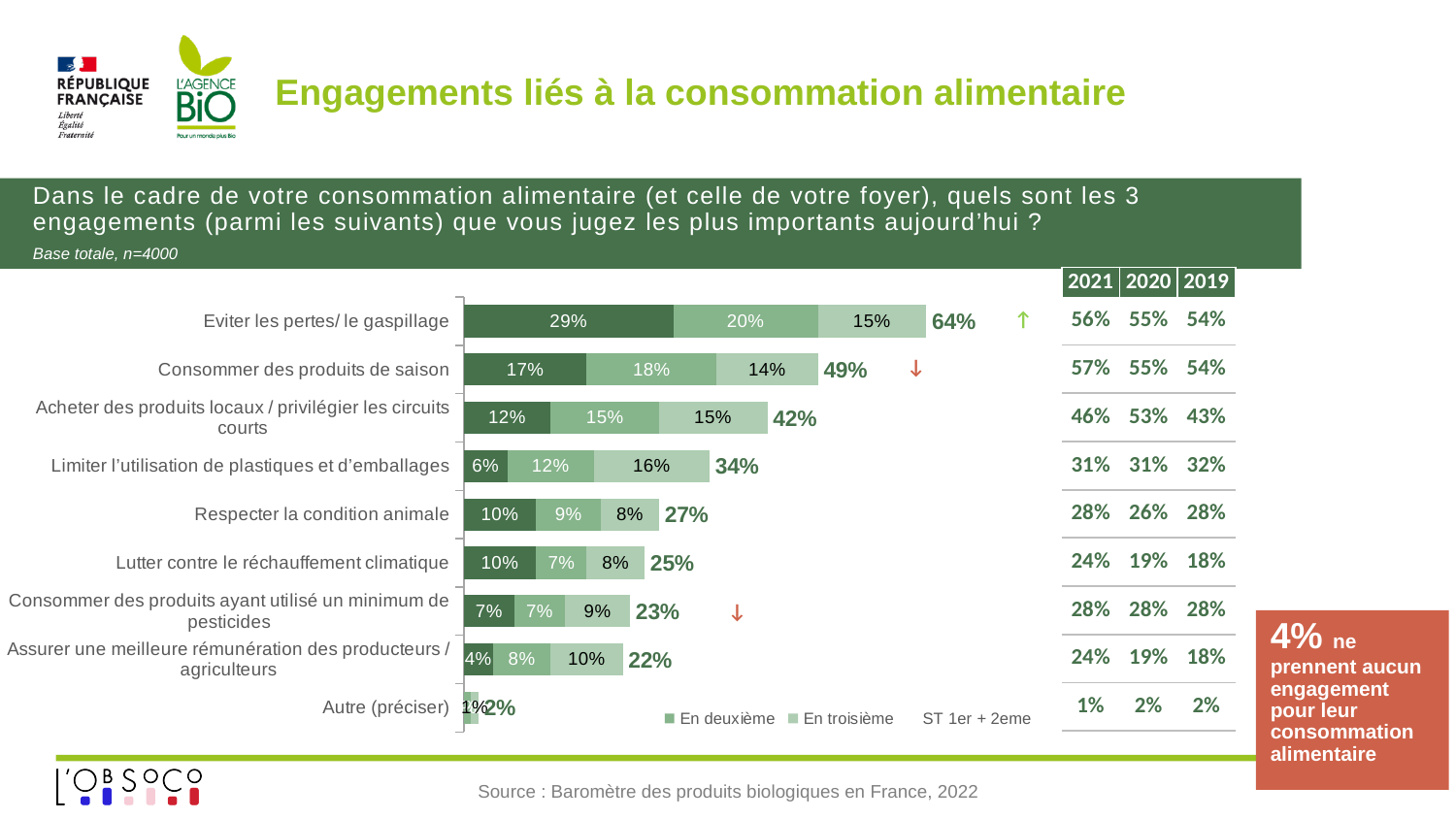
Do the bold total values increase or decrease going from the top category to the bottom category? decrease Which category has the lowest bold total value? Autre (préciser) What is the bold total value shown at the end of the bar for 'Eviter les pertes/ le gaspillage'? 64% What is the 'En troisième' value for 'Limiter l'utilisation de plastiques et d'emballages'? 16% Which has the larger bold total: 'Respecter la condition animale' or 'Lutter contre le réchauffement climatique'? Respecter la condition animale What is the 'En deuxième' value for 'Consommer des produits de saison'? 18% How many categories (engagements) are plotted in the chart? 9 What is the difference between the bold total for 'Eviter les pertes/ le gaspillage' and the bold total for 'Consommer des produits de saison'? 15 percentage points What is the total of the stacked bar for 'Acheter des produits locaux / privilégier les circuits courts'? 42% What kind of chart is shown on the slide? bar chart Which category has the highest bold total value? Eviter les pertes/ le gaspillage In the table to the right of the chart, what is the 2021 value for 'Eviter les pertes/ le gaspillage'? 56%